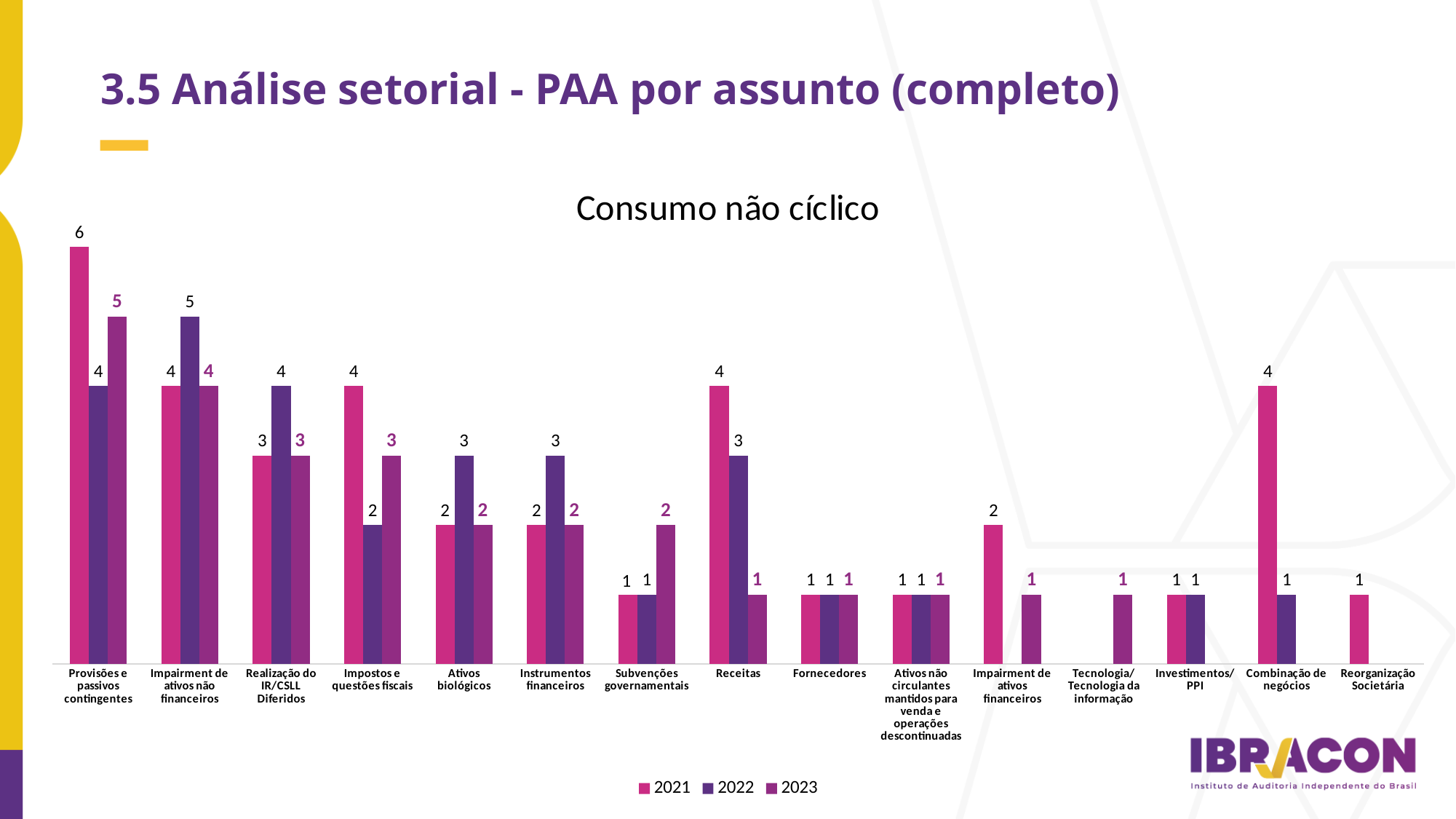
What is the title of the chart? Consumo não cíclico What kind of chart is shown on the slide? Bar chart What is the 2022 value for Impairment de ativos não financeiros? 5 What is the 2021 value for Provisões e passivos contingentes? 6 How many series does the legend list? 3 What is the difference between the 2021 and 2023 values for Receitas? 3 What is the 2021 value for Combinação de negócios? 4 Which is larger for Impostos e questões fiscais: the 2021 value or the 2022 value? 2021 How many categories are shown on the x axis? 15 Which category has the highest 2021 value? Provisões e passivos contingentes What is the 2023 value for Subvenções governamentais? 2 What is the total of the three series values for Ativos biológicos? 7